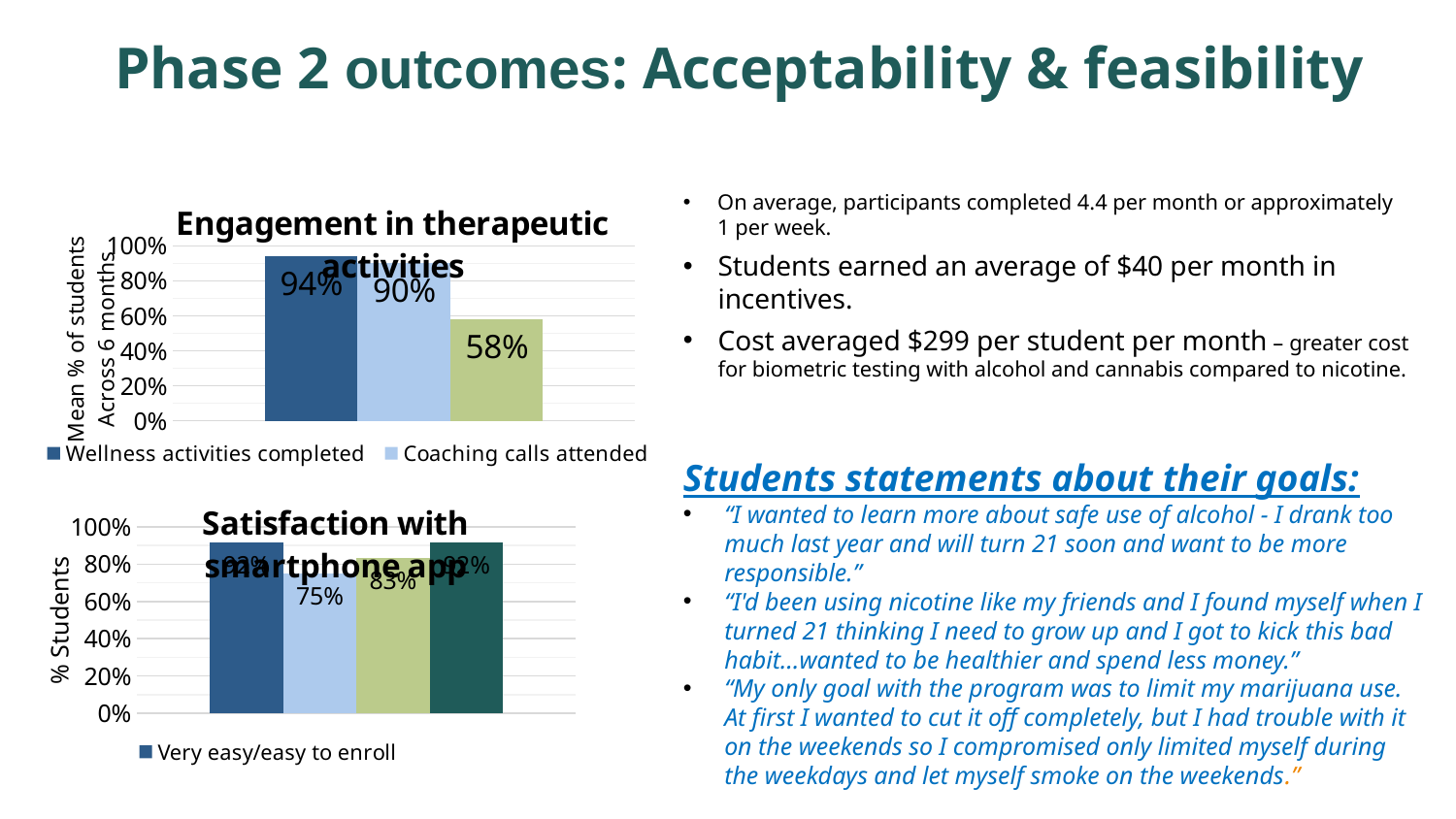
How many bars are plotted in the 'Engagement in therapeutic activities' chart? 3 In the 'Engagement in therapeutic activities' chart, what is the lowest value shown? 58% What is the y-axis title of the 'Engagement in therapeutic activities' chart? Mean % of students Across 6 months In the 'Satisfaction with smartphone app' chart, what is the lowest value shown? 75% How many bars are plotted in the 'Satisfaction with smartphone app' chart? 4 What kind of chart is the 'Engagement in therapeutic activities' chart? Bar chart In the 'Engagement in therapeutic activities' chart, what is the value for Wellness activities completed? 94% In the 'Engagement in therapeutic activities' chart, what is the difference between Wellness activities completed and Coaching calls attended? 4 percentage points In the 'Engagement in therapeutic activities' chart, what is the difference between the highest value (94%) and the lowest value (58%)? 36 percentage points In the 'Engagement in therapeutic activities' chart, which series has the highest value? Wellness activities completed In the 'Engagement in therapeutic activities' chart, what is the value for Coaching calls attended? 90% In the 'Satisfaction with smartphone app' chart, is the value for Very easy/easy to enroll greater or less than 80%? greater